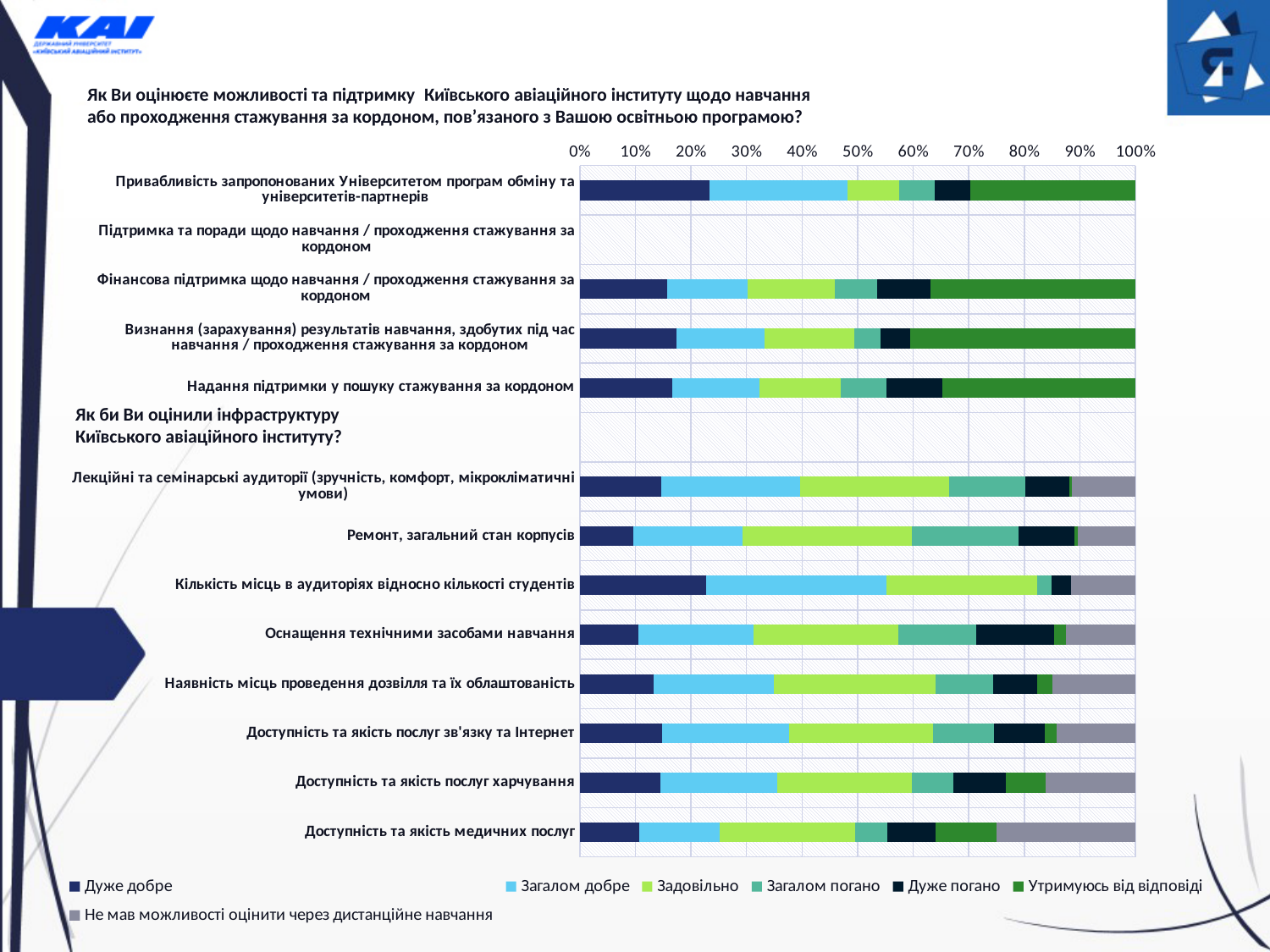
Which has the larger 'Дуже добре' share: 'Кількість місць в аудиторіях відносно кількості студентів' or 'Ремонт, загальний стан корпусів'? Кількість місць в аудиторіях відносно кількості студентів Is the 'Не мав можливості оцінити через дистанційне навчання' share for 'Кількість місць в аудиторіях відносно кількості студентів' greater or less than 20%? less What kind of chart is shown on the slide? Stacked bar chart Is the 'Задовільно' share for 'Ремонт, загальний стан корпусів' greater or less than 20%? greater Is the 'Не мав можливості оцінити через дистанційне навчання' share for 'Доступність та якість медичних послуг' greater or less than 20%? greater Which legend entry is shown in grey? Не мав можливості оцінити через дистанційне навчання How many series does the chart legend list? 7 Which legend entry is shown in dark green? Утримуюсь від відповіді What is the highest value shown on the percentage axis? 100% Which category has the largest 'Не мав можливості оцінити через дистанційне навчання' share? Доступність та якість медичних послуг Which has the larger 'Задовільно' share: 'Ремонт, загальний стан корпусів' or 'Привабливість запропонованих Університетом програм обміну та університетів-партнерів'? Ремонт, загальний стан корпусів